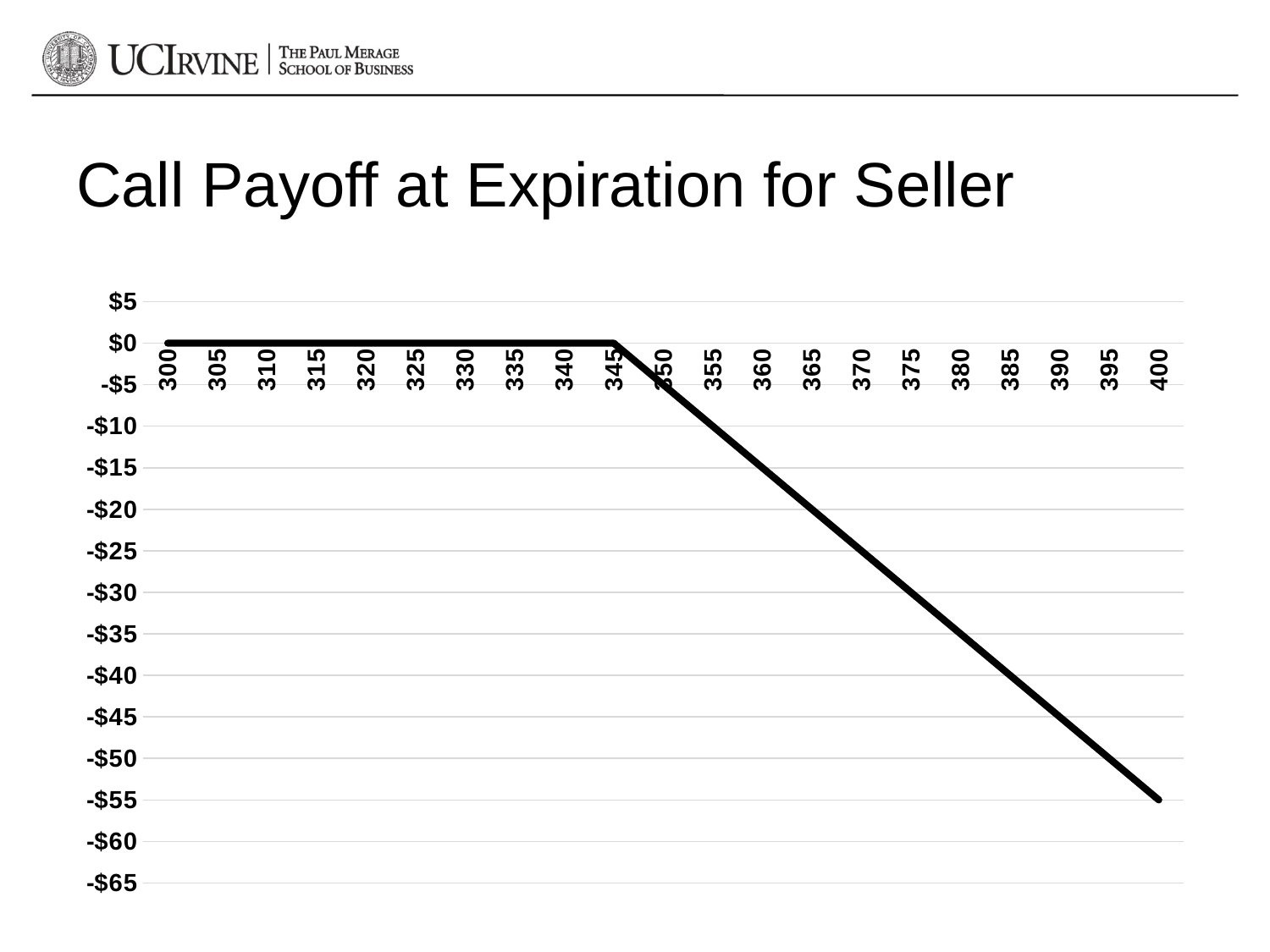
How many x-axis categories (stock prices) are plotted on the chart? 21 What is the title of the chart? Call Payoff at Expiration for Seller What is the payoff value at a stock price of 400? -$55 Is the payoff at a stock price of 380 greater or less than -$30? less Does the payoff rise or fall as the stock price increases from 345 to 400? fall At which stock price is the payoff lowest? 400 What kind of chart is shown on the slide? line chart What is the difference between the payoff at 300 and the payoff at 400? $55 What is the payoff value at a stock price of 300? $0 Which is larger, the payoff at a stock price of 320 or at 390? 320 Is the payoff at a stock price of 360 greater or less than -$20? greater What is the payoff value at a stock price of 345? $0